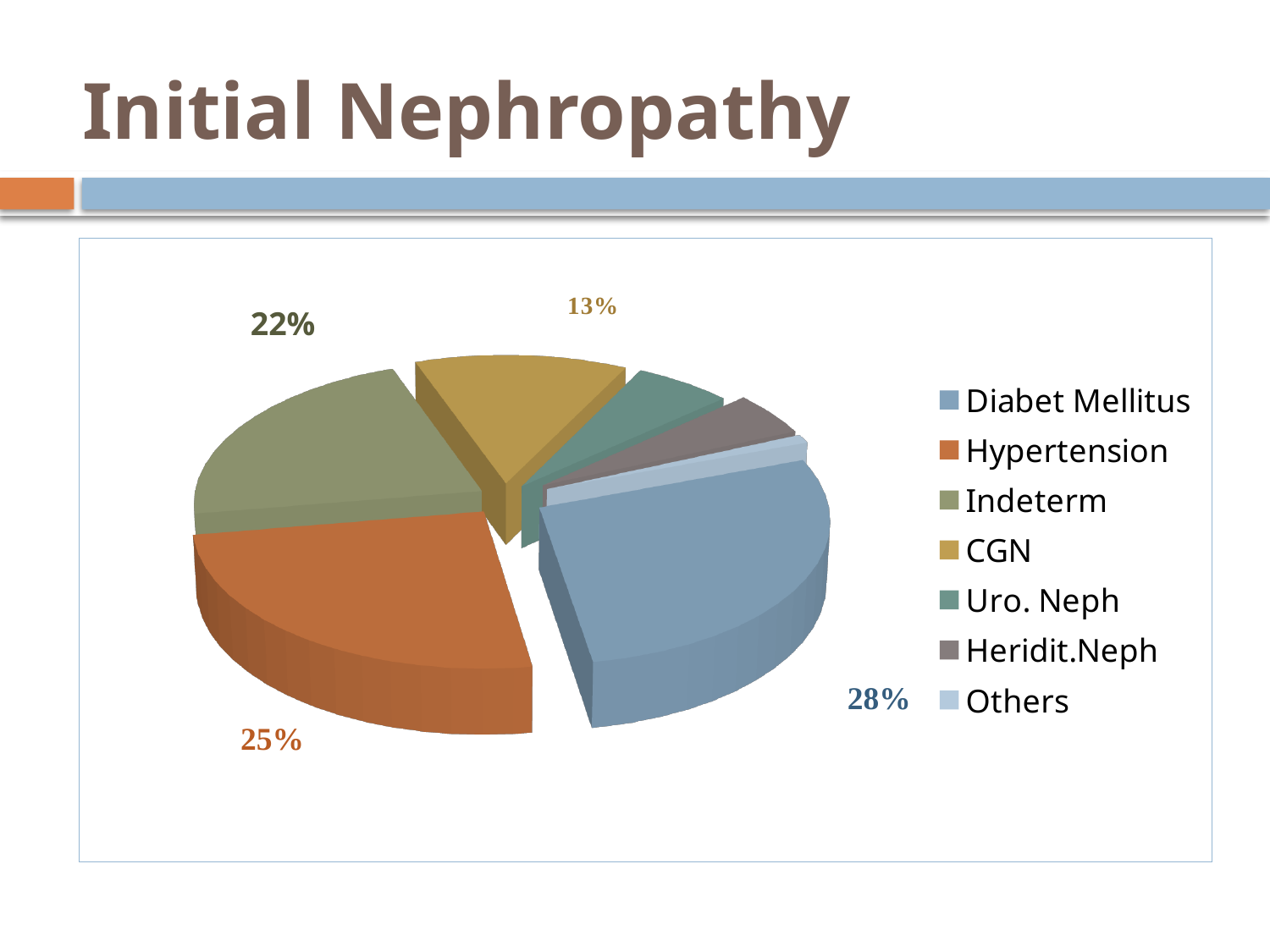
What percentage is shown for Indeterm? 22% How many categories does the legend list? 7 What percentage is shown for Hypertension? 25% What is the difference in percentage points between Diabet Mellitus and CGN? 15 What is the title of the slide containing the chart? Initial Nephropathy What is the difference in percentage points between Hypertension and Indeterm? 3 Which legend entry is shown in orange? Hypertension What share of the pie does Diabet Mellitus account for? 28% What percentage is shown for CGN? 13% What kind of chart is shown on the slide? Pie chart Which category has the largest slice of the pie? Diabet Mellitus Which is larger, the share for Hypertension or the share for Indeterm? Hypertension